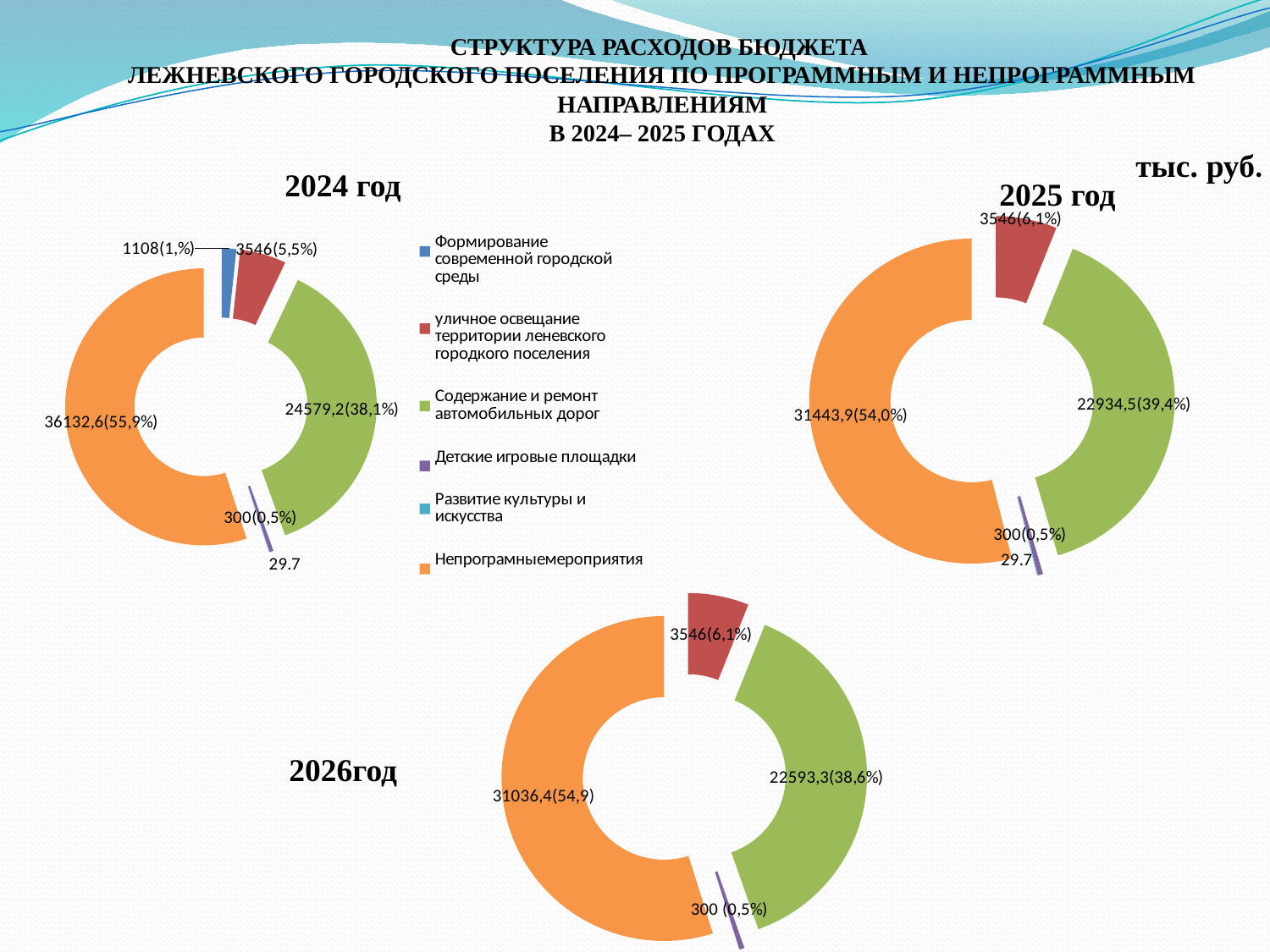
In the 2024 год chart, what is the difference between the orange segment (36132,6) and the green segment (24579,2)? 11553,4 How many entries does the legend on the slide list? 6 What kind of chart is used for the 2024 год chart? Doughnut (pie) chart In the 2025 год chart, what share of the total does the orange segment (Непрограмные мероприятия) represent? 54,0% In the 2024 год chart, what is the value labelled for the green segment (Содержание и ремонт автомобильных дорог)? 24579,2(38,1%) In the 2026 год chart, which is larger: the orange segment or the green segment? The orange segment (31036,4) In the 2024 год chart, which labelled segment has the smallest value? Развитие культуры и искусства (29.7) In the 2024 год chart, what is the value labelled for the orange segment (Непрограмные мероприятия)? 36132,6(55,9%) In the 2025 год chart, what is the difference between the orange segment (31443,9) and the green segment (22934,5)? 8509,4 In the 2025 год chart, which segment is the largest? Непрограмные мероприятия (31443,9) In the 2026 год chart, what is the value labelled for the green segment? 22593,3(38,6%) In the 2025 год chart, what is the value labelled for the red segment (уличное освещание)? 3546(6,1%)